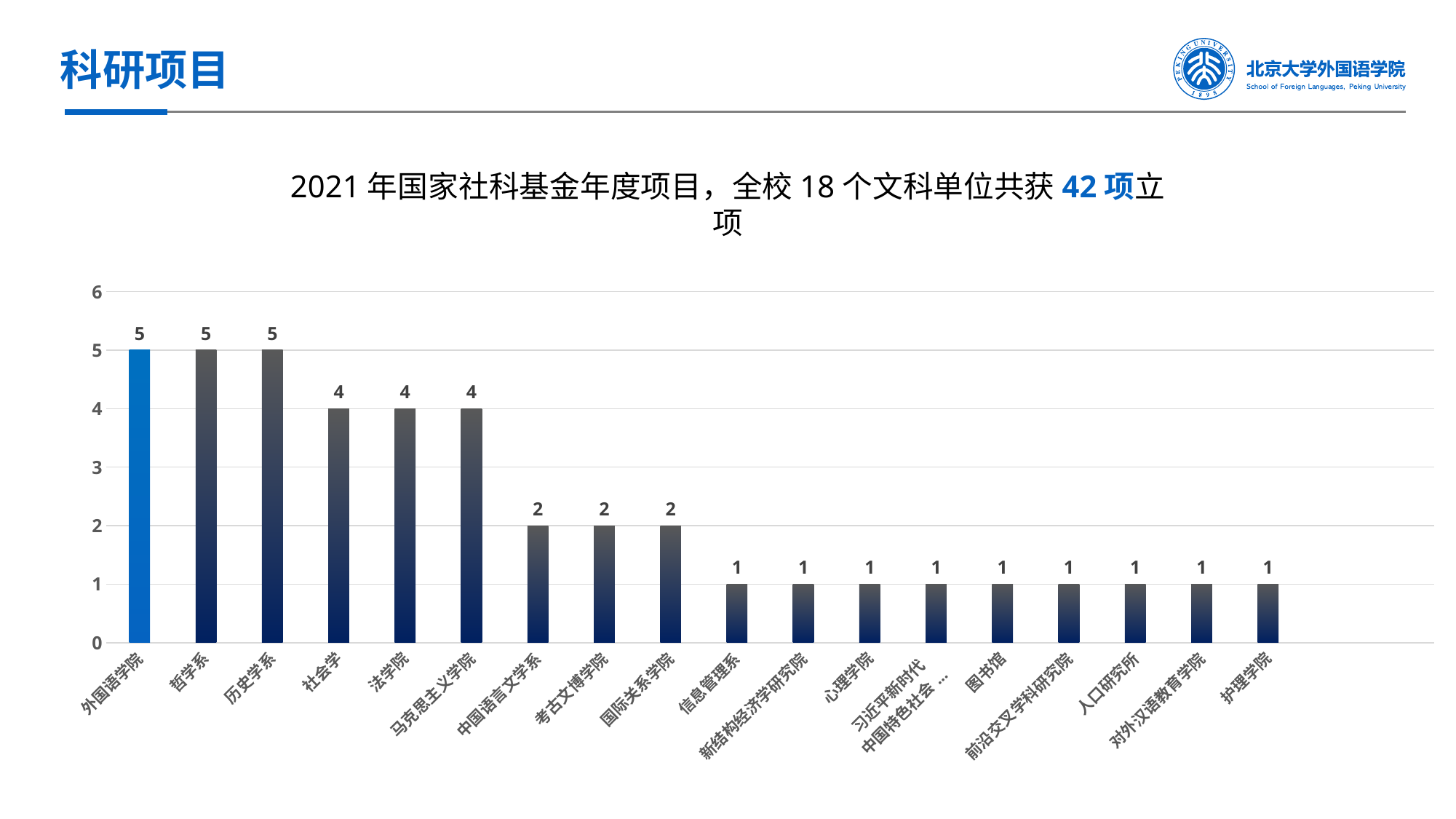
What value is shown for 社会学? 4 What value is shown for 国际关系学院? 2 Which has a larger value, 考古文博学院 or 心理学院? 考古文博学院 How many categories (units) are shown on the x axis of the chart? 18 What is the difference between the values for 哲学系 and 中国语言文学系? 3 What kind of chart is shown on the slide? bar chart Do the values generally rise or fall moving from left to right along the x axis? fall What value is shown for 外国语学院? 5 What is the difference between the values for 法学院 and 护理学院? 3 Which bar is highlighted in a different (bright blue) colour from the others? 外国语学院 Which has a larger value, 历史学系 or 马克思主义学院? 历史学系 What value is shown for 图书馆? 1